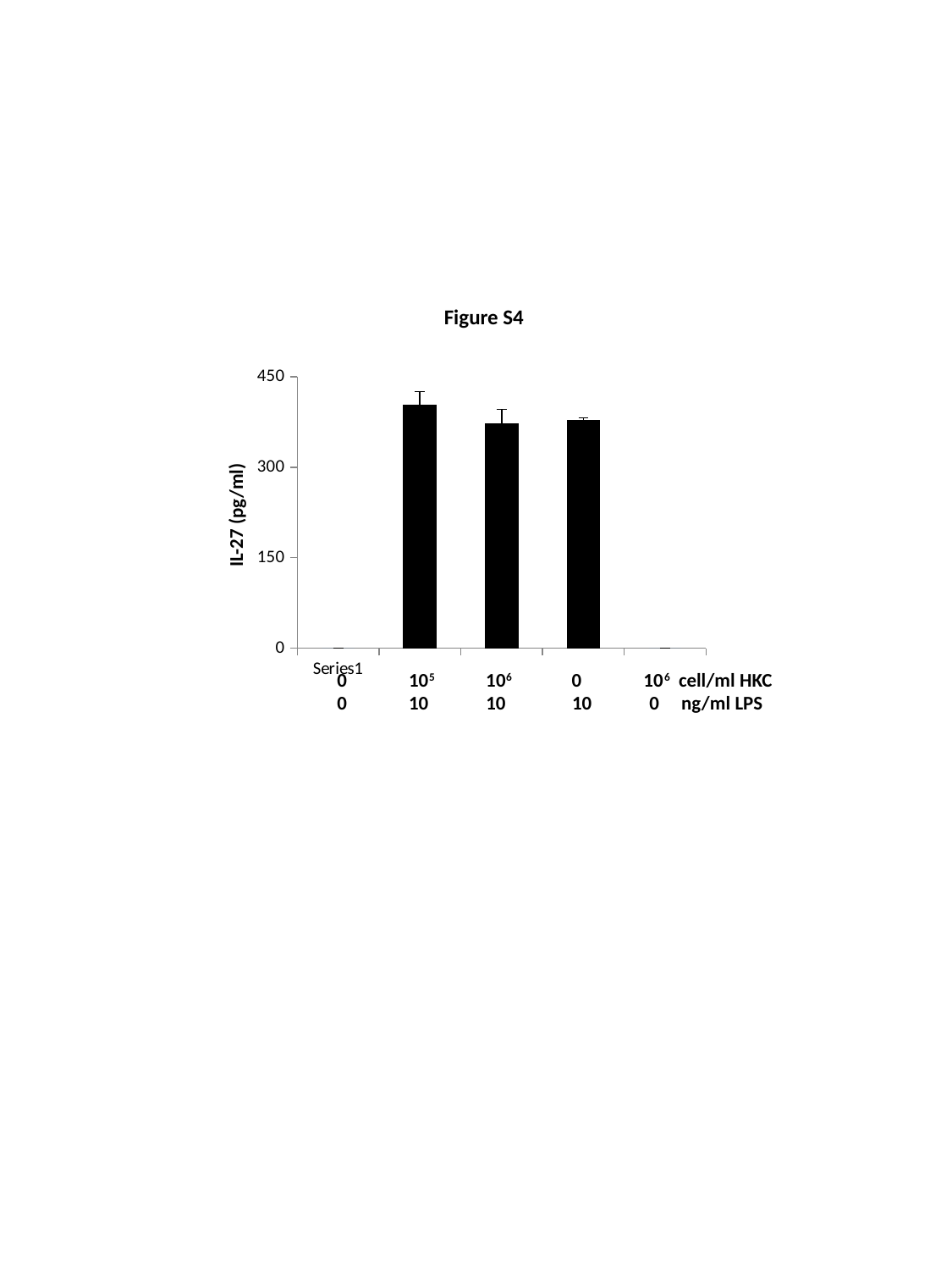
Is the IL-27 value for 10^5 cell/ml HKC with 10 ng/ml LPS greater or less than 300? greater Is the IL-27 value for 10^6 cell/ml HKC with 0 ng/ml LPS greater or less than 150? less What is the title of the chart? Figure S4 Is the IL-27 value for 0 cell/ml HKC with 0 ng/ml LPS greater or less than 150? less How many bars (conditions) are plotted along the x axis? 5 Which condition has the highest IL-27 value? 10^5 cell/ml HKC with 10 ng/ml LPS What kind of chart is shown on the slide? bar chart What is the label on the y axis of the chart? IL-27 (pg/ml)